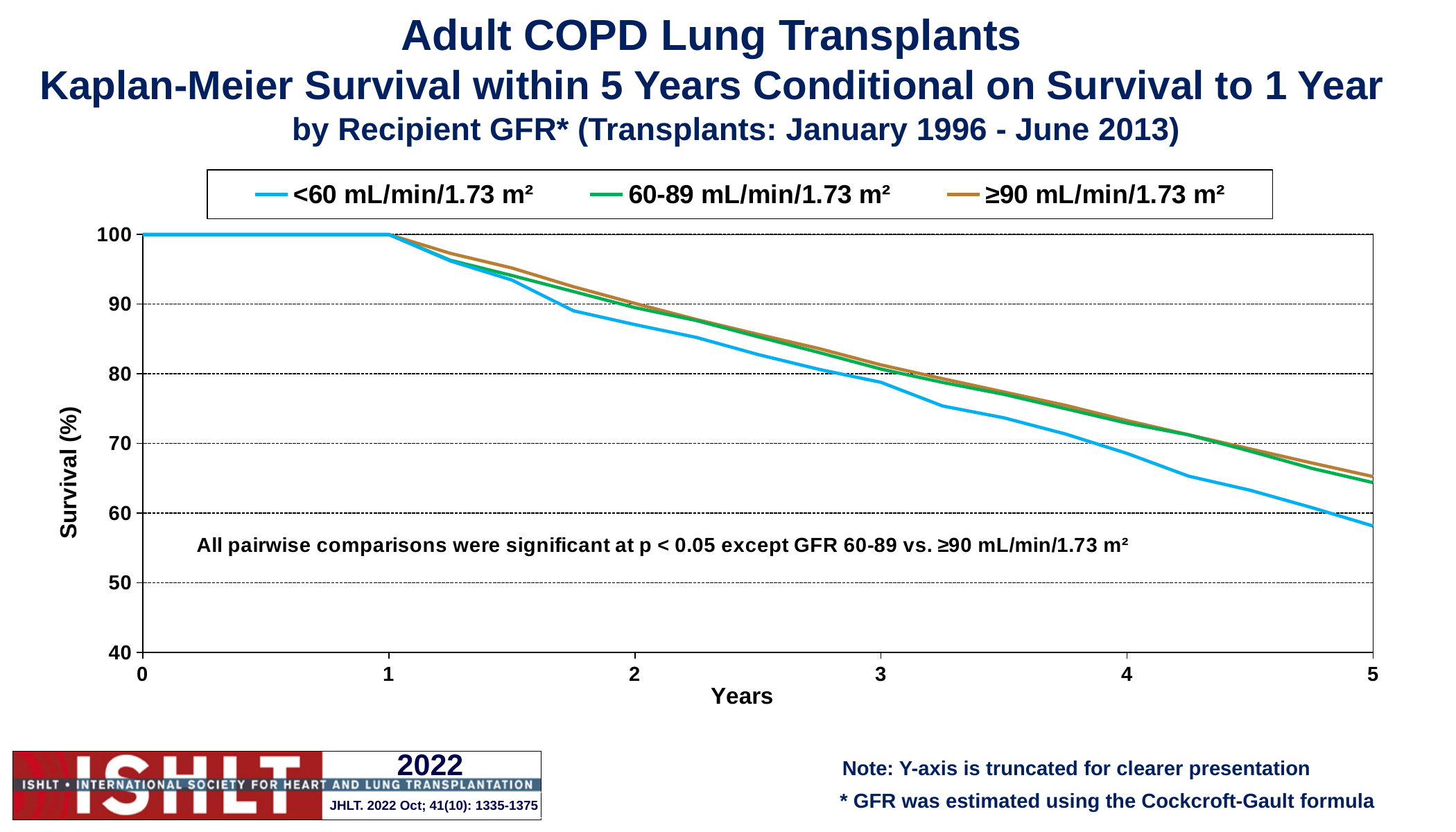
What kind of chart is shown on the slide? line chart How many series does the legend list? 3 Is the survival value for the <60 mL/min/1.73 m² group at year 2 greater or less than 90? less What is the survival value for the <60 mL/min/1.73 m² group at year 1? 100 At year 5, which group has higher survival: <60 mL/min/1.73 m² or 60-89 mL/min/1.73 m²? 60-89 mL/min/1.73 m² Is the survival value for the 60-89 mL/min/1.73 m² group at year 5 greater or less than 60? greater Which group has the lowest survival at year 5? <60 mL/min/1.73 m² What is the label of the y-axis? Survival (%) Do the survival curves rise or fall as years increase after year 1? fall What is the survival value for the ≥90 mL/min/1.73 m² group at year 1? 100 Which colour represents the <60 mL/min/1.73 m² group? blue Is the survival value for the ≥90 mL/min/1.73 m² group at year 4 greater or less than 70? greater